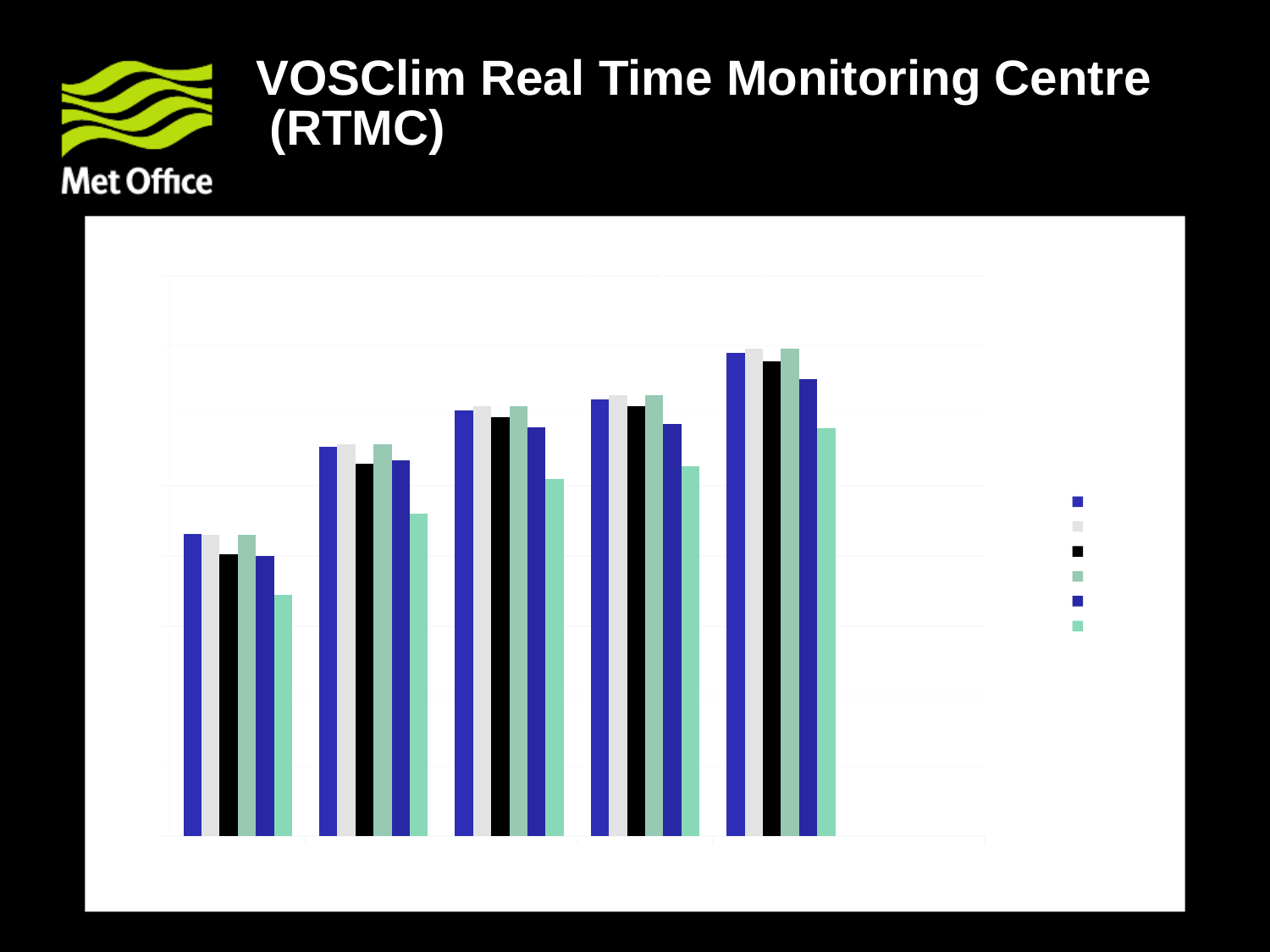
How many bars are in each group? 6 Is the legend placed to the right of the plot area or below it? to the right What kind of chart is shown on the slide? bar chart How many groups of bars are plotted along the x axis? 5 Do the bar heights generally rise or fall from left to right along the x axis? rise How many series does the legend list? 6